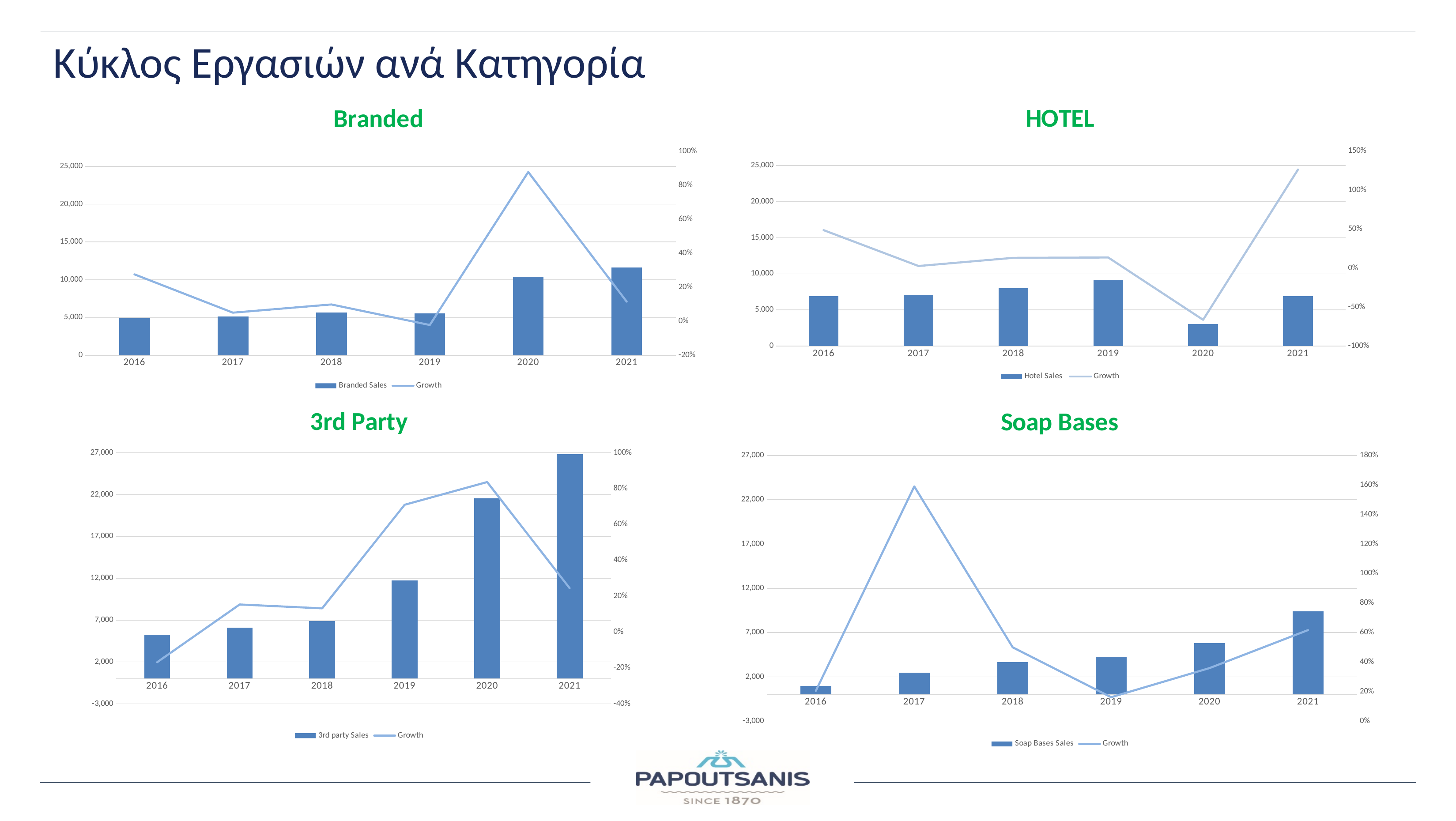
In the Soap Bases chart, which year has the lowest Soap Bases Sales bar? 2016 In the 3rd Party chart, is the 3rd party Sales value for 2020 greater or less than 17,000? greater In the Branded chart, is the Branded Sales value for 2021 greater or less than 10,000? greater In the Branded chart, which year has the highest Branded Sales bar? 2021 In the Soap Bases chart, which year does the Growth line reach its peak? 2017 In the HOTEL chart, which year has the highest Hotel Sales bar? 2019 How many years are shown on the x axis of the Branded chart? 6 In the HOTEL chart, which year has the lowest Hotel Sales bar? 2020 In the HOTEL chart, is the Hotel Sales value for 2020 greater or less than 5,000? less In the 3rd Party chart, is the 3rd party Sales bar for 2020 larger or smaller than the bar for 2019? larger How many series does the legend of the Soap Bases chart list? 2